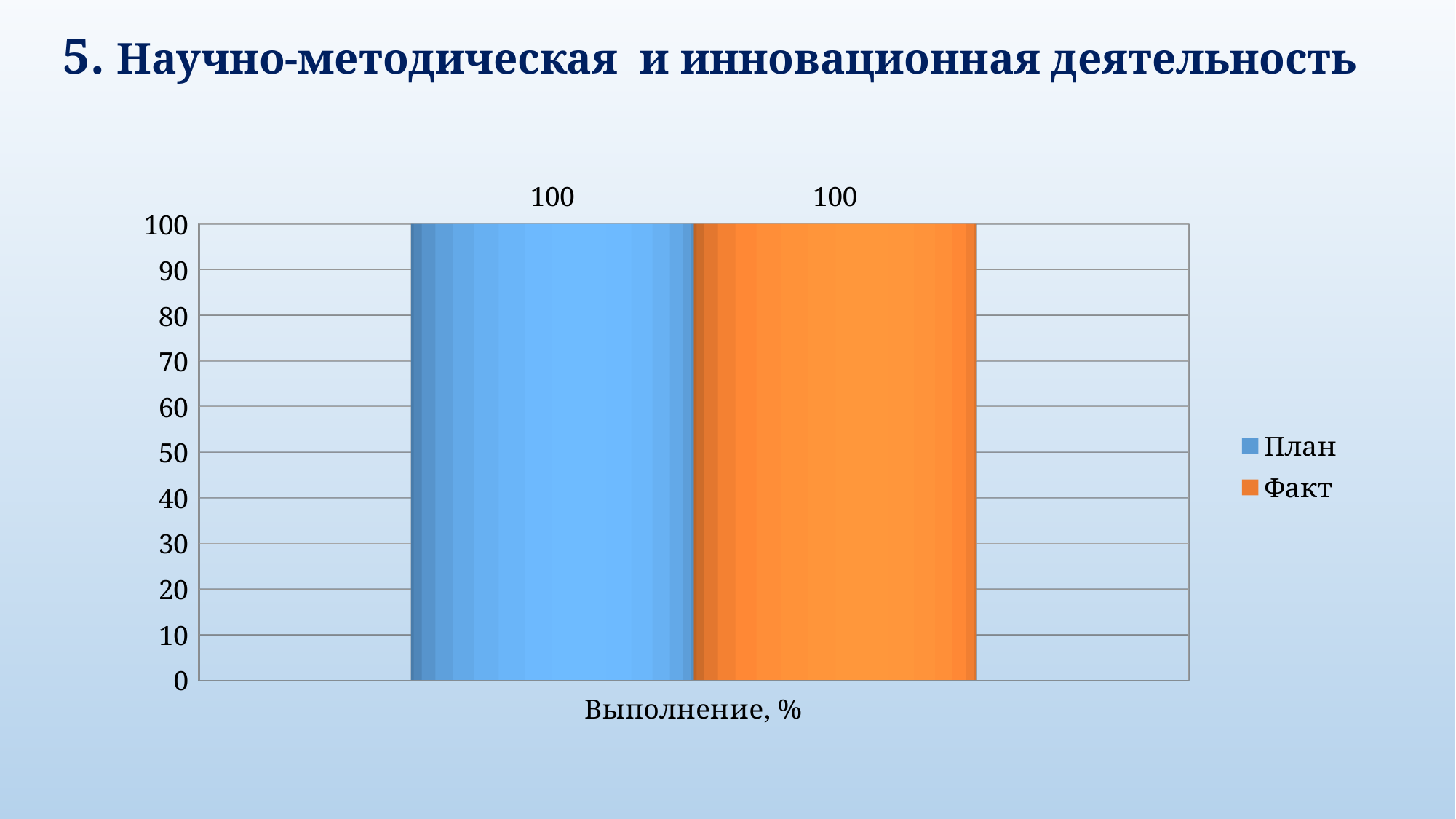
What is the value of План for Выполнение, %? 100 How many categories are shown on the x axis? 1 What is the value of Факт for Выполнение, %? 100 What is the category label on the x axis? Выполнение, % How many series does the legend list? 2 Which series is shown in orange? Факт What is the highest value shown on the y axis? 100 What kind of chart is shown on the slide? bar chart What is the difference between the План and Факт values for Выполнение, %? 0 Is the value for Факт greater or less than 50? greater